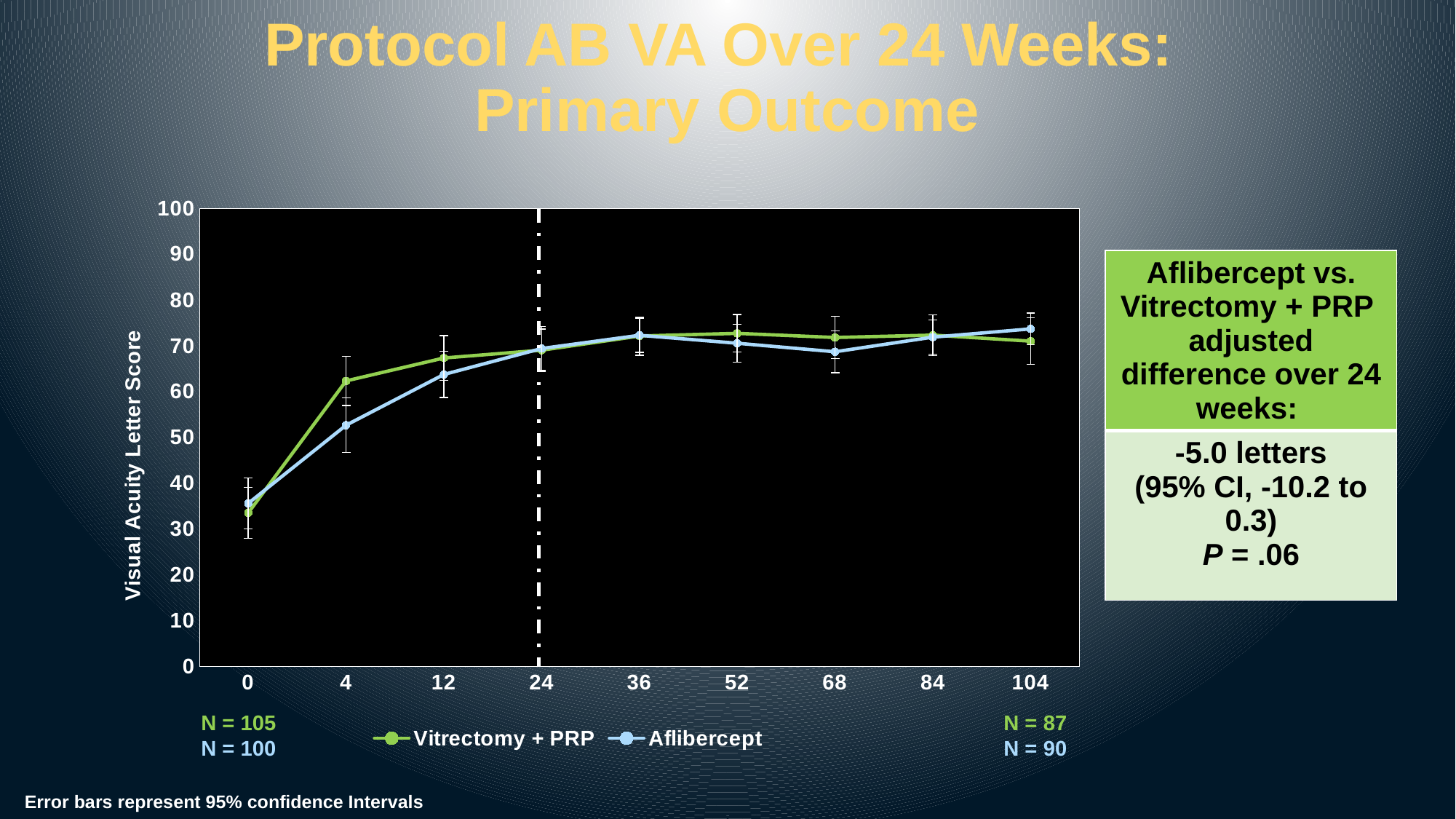
Is the value for Vitrectomy + PRP at week 0 greater or less than 40? less How many time points are marked on the x axis? 9 At which week is the Aflibercept series at its lowest value? 0 Is the value for Vitrectomy + PRP at week 4 greater or less than 50? greater Is the value for Aflibercept at week 104 greater or less than 70? greater Does the Aflibercept line rise or fall from week 0 to week 24? rise How many series does the legend list? 2 At week 4, which series has the higher visual acuity letter score? Vitrectomy + PRP What kind of chart is shown on the slide? line chart At week 68, which series has the higher visual acuity letter score? Vitrectomy + PRP What is the label of the y axis? Visual Acuity Letter Score